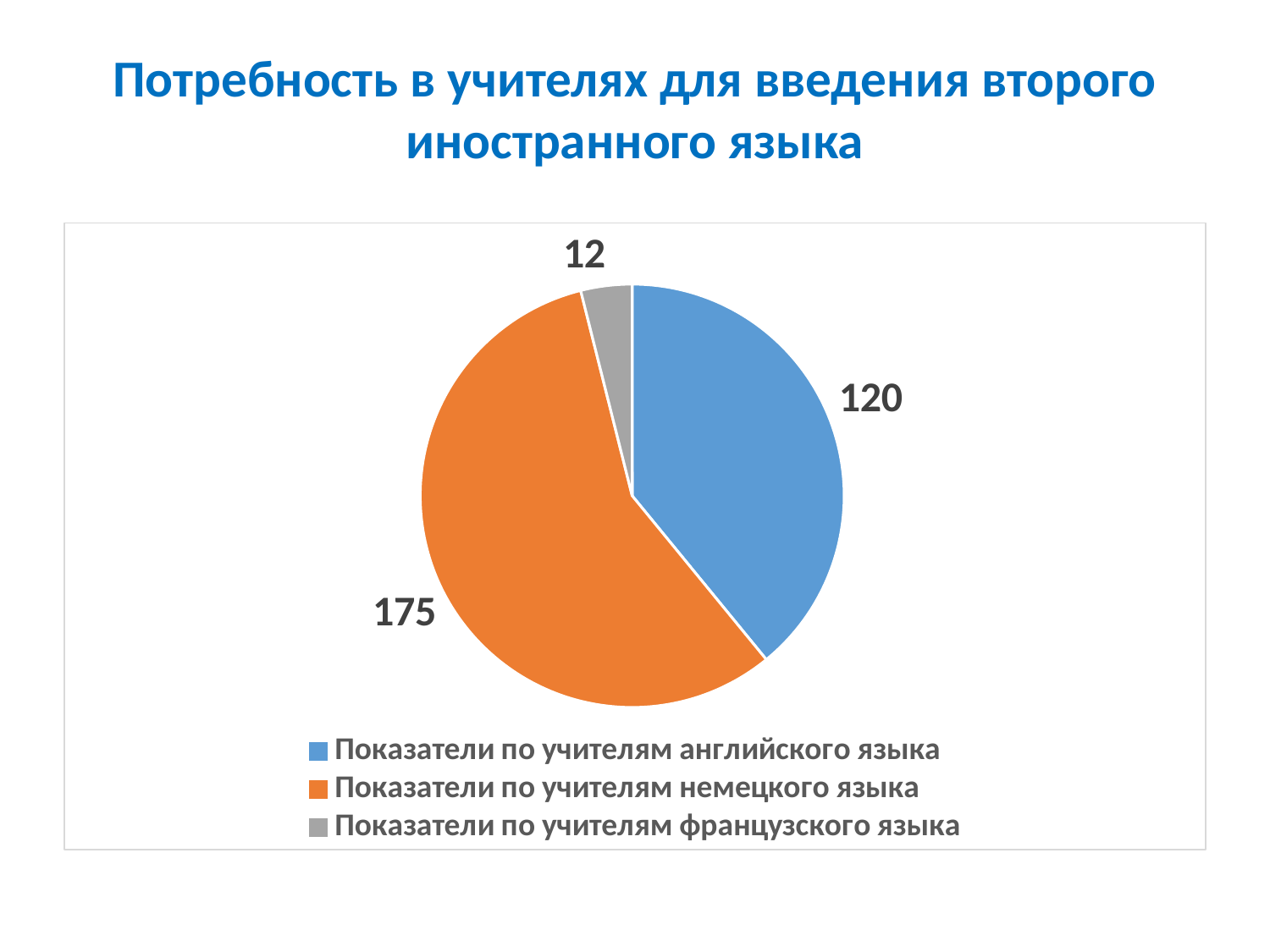
What is the value for Показатели по учителям французского языка? 12 Which category has the smallest slice of the pie? Показатели по учителям французского языка What is the total of all three slices in the pie chart? 307 What is the difference between the values for German language teachers and English language teachers? 55 What is the difference between the values for English language teachers and French language teachers? 108 Which category has the largest slice of the pie? Показатели по учителям немецкого языка What kind of chart is shown on the slide? pie chart What is the value for Показатели по учителям немецкого языка? 175 How many slices does the pie chart have? 3 What colour is the slice for Показатели по учителям французского языка? grey What is the value for Показатели по учителям английского языка? 120 Which is larger: the value for English language teachers or the value for German language teachers? Показатели по учителям немецкого языка